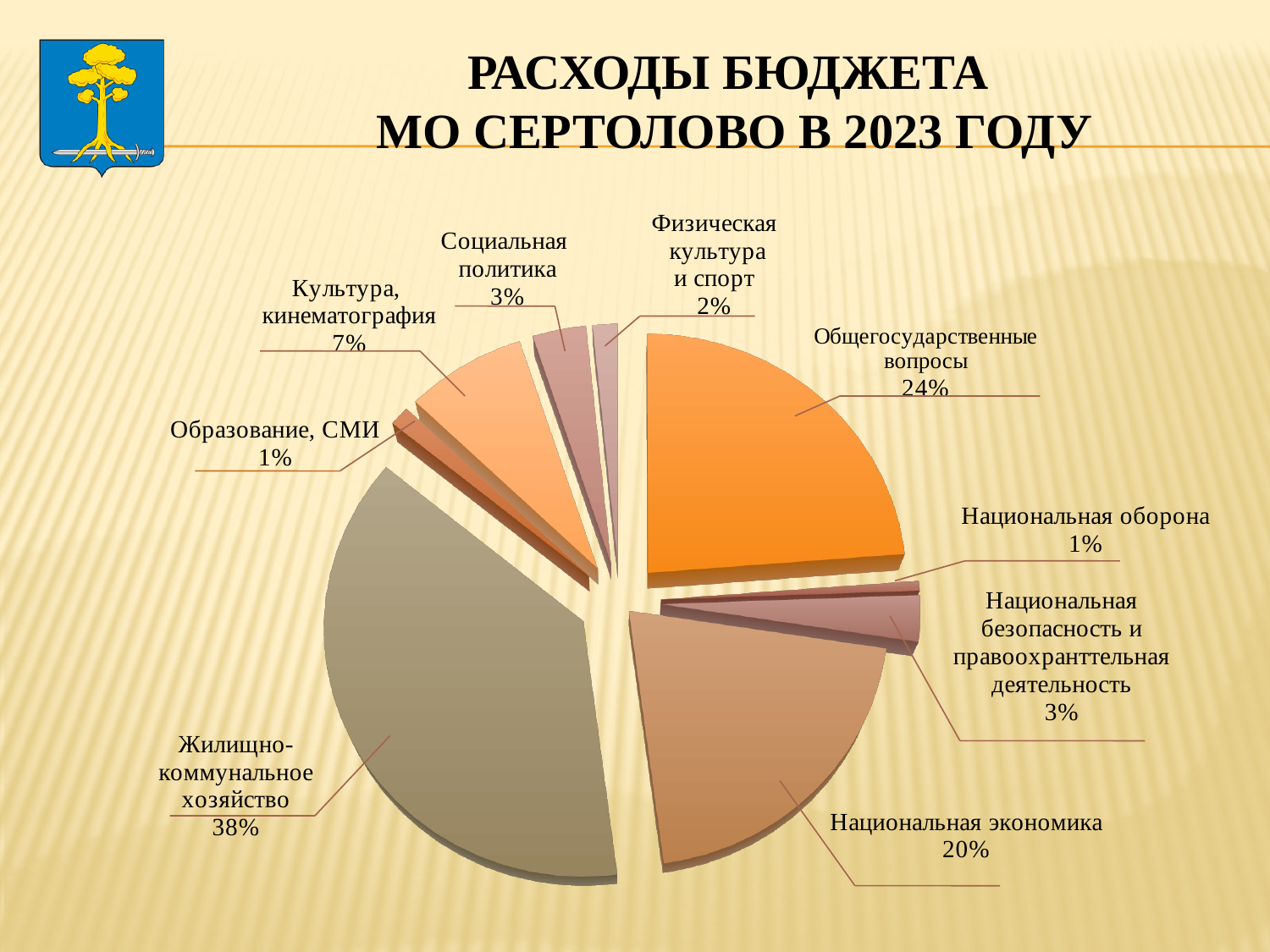
How many slices does the pie chart have? 9 What is the combined share of Национальная оборона and Образование, СМИ? 2% What share is labelled for Культура, кинематография? 7% What percentage is shown for Физическая культура и спорт? 2% What is the difference in percentage points between Общегосударственные вопросы and Национальная экономика? 4 What percentage is shown for Общегосударственные вопросы? 24% What kind of chart is shown on the slide? pie chart What share of the budget expenses goes to Жилищно-коммунальное хозяйство? 38% Which category has the largest share of the pie? Жилищно-коммунальное хозяйство What is the title of the chart on the slide? РАСХОДЫ БЮДЖЕТА МО СЕРТОЛОВО В 2023 ГОДУ Which is larger, the share for Социальная политика or the share for Культура, кинематография? Культура, кинематография What percentage is shown for Национальная экономика? 20%